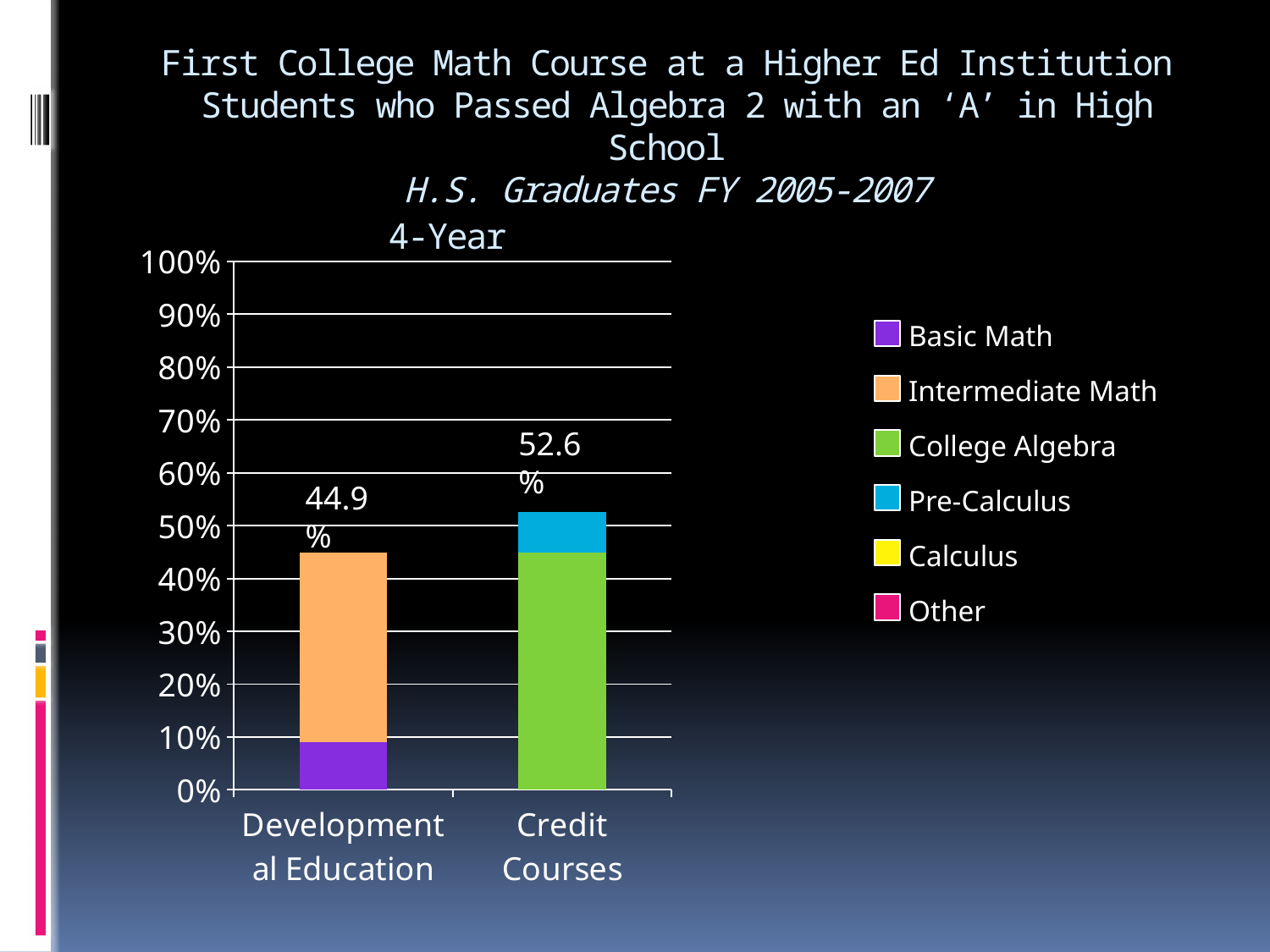
What is the title printed directly above the chart area? 4-Year What is the total labeled on the Credit Courses bar? 52.6% What is the difference between the Credit Courses total and the Developmental Education total? 7.7% What is the total labeled on the Developmental Education bar? 44.9% Is the total for Developmental Education greater or less than 50%? less Is the total for Credit Courses greater or less than 50%? greater Which category has the taller stacked bar, Developmental Education or Credit Courses? Credit Courses How many categories are shown on the x axis? 2 What kind of chart is shown on the slide? Stacked bar chart Which series is shown in green in the legend? College Algebra How many series does the legend list? 6